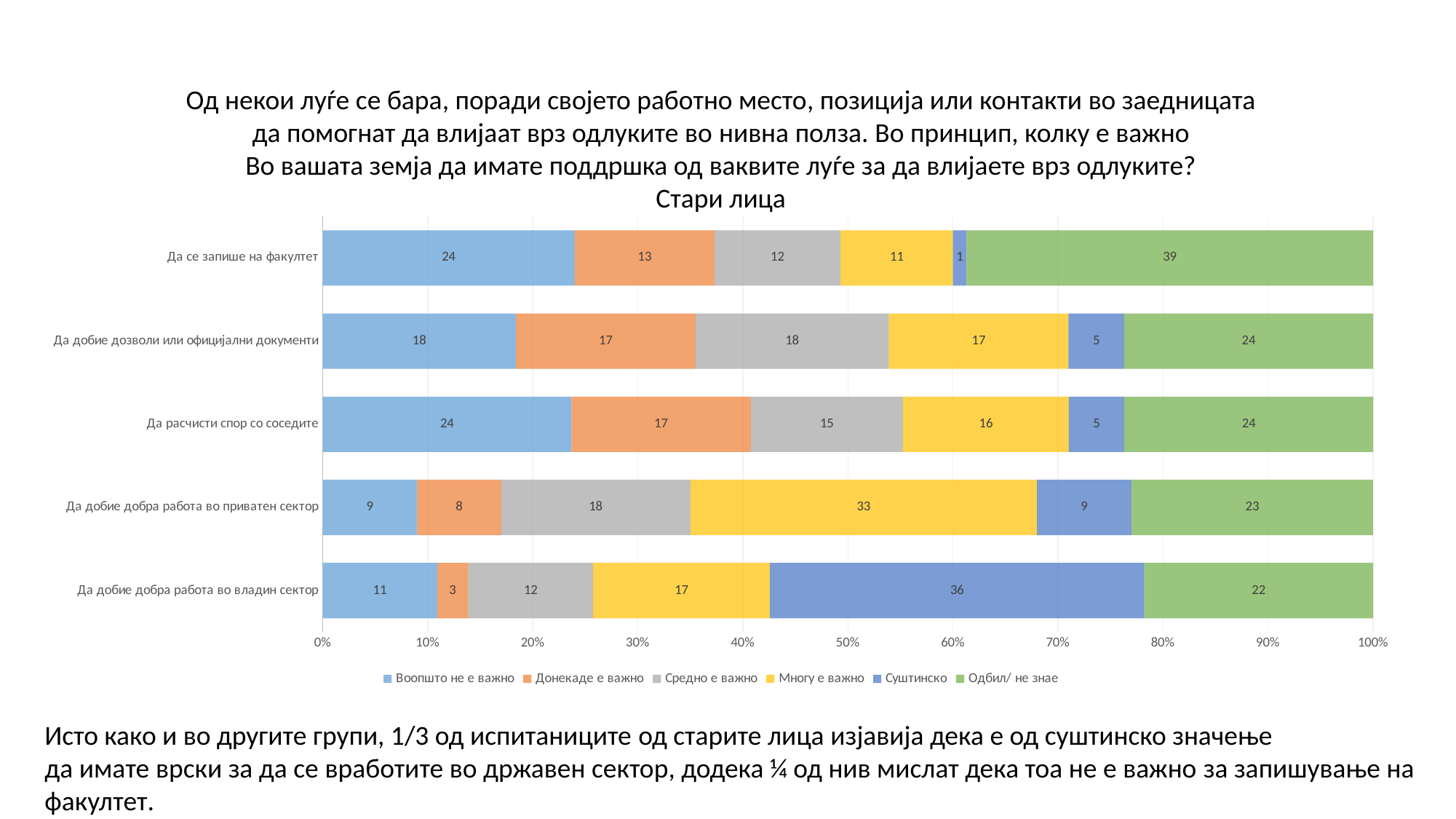
Which series is shown in green in the chart? Одбил/ не знае Which category has the lowest value for "Донекаде е важно"? Да добие добра работа во владин сектор What is the value of "Суштинско" for "Да добие добра работа во владин сектор"? 36 How many series does the legend list? 6 Which category has the highest value for "Суштинско"? Да добие добра работа во владин сектор What is the value of "Воопшто не е важно" for "Да добие дозволи или официјални документи"? 18 How many categories (rows) are plotted in the chart? 5 What is the value of "Одбил/ не знае" for "Да се запише на факултет"? 39 What is the difference between the "Одбил/ не знае" value for "Да се запише на факултет" and for "Да добие добра работа во владин сектор"? 17 What kind of chart is shown on the slide? Stacked bar chart What is the value of "Многу е важно" for "Да добие добра работа во приватен сектор"? 33 Which is larger: the "Воопшто не е важно" value for "Да расчисти спор со соседите" or for "Да добие добра работа во приватен сектор"? Да расчисти спор со соседите